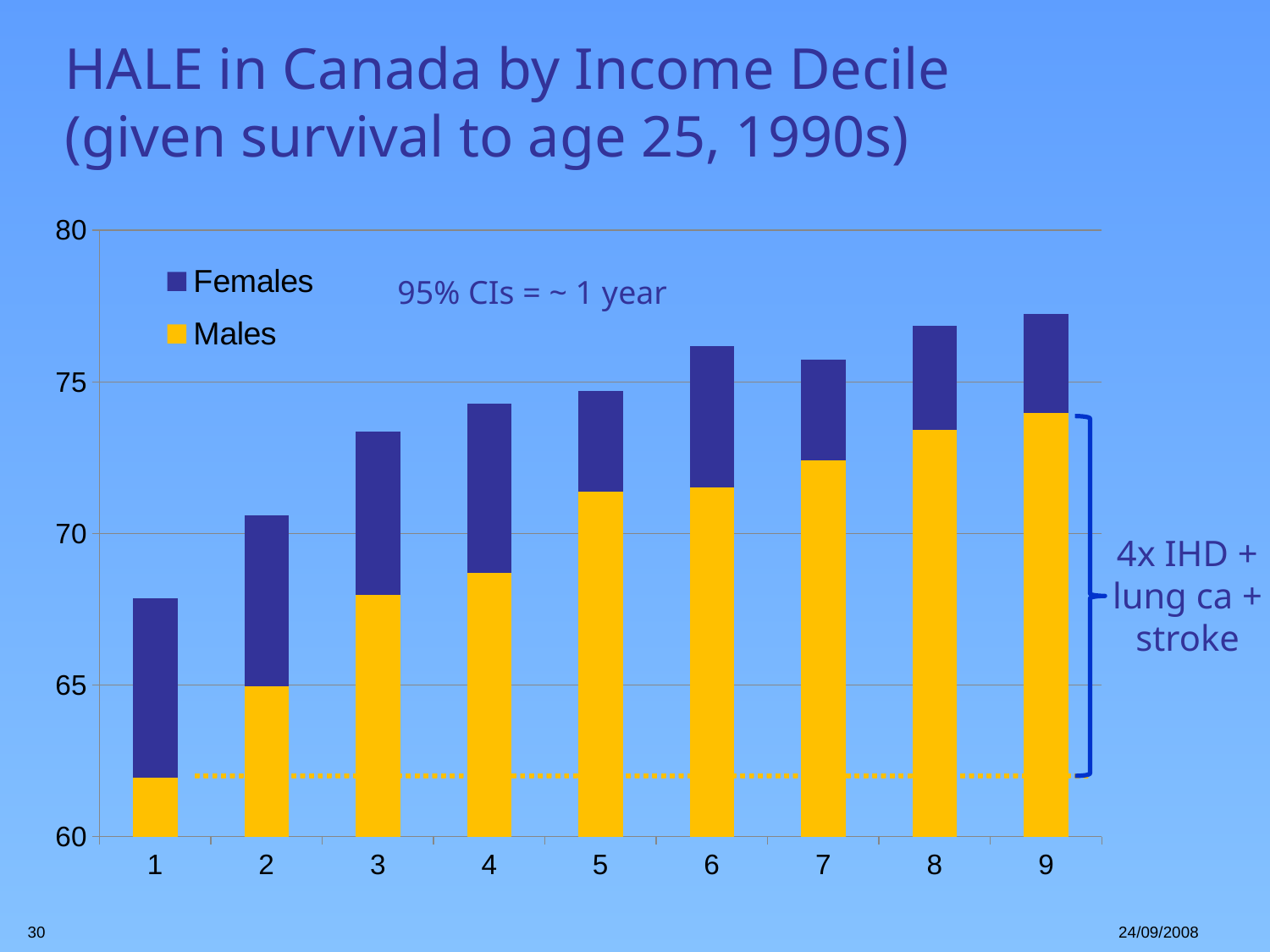
How many income deciles are shown on the x axis? 9 Is the Males value for decile 3 greater or less than 65? greater How many series does the legend list? 2 Is the Males value for decile 5 greater or less than 70? greater Is the top of the bar for decile 9 greater or less than 75? greater Which series is shown in yellow in the legend? Males Which income decile has the tallest bar overall? 9 What kind of chart is shown on the slide? Stacked bar chart Which income decile has the shortest bar overall? 1 Do the bar heights generally rise or fall as the income decile increases from 1 to 9? rise